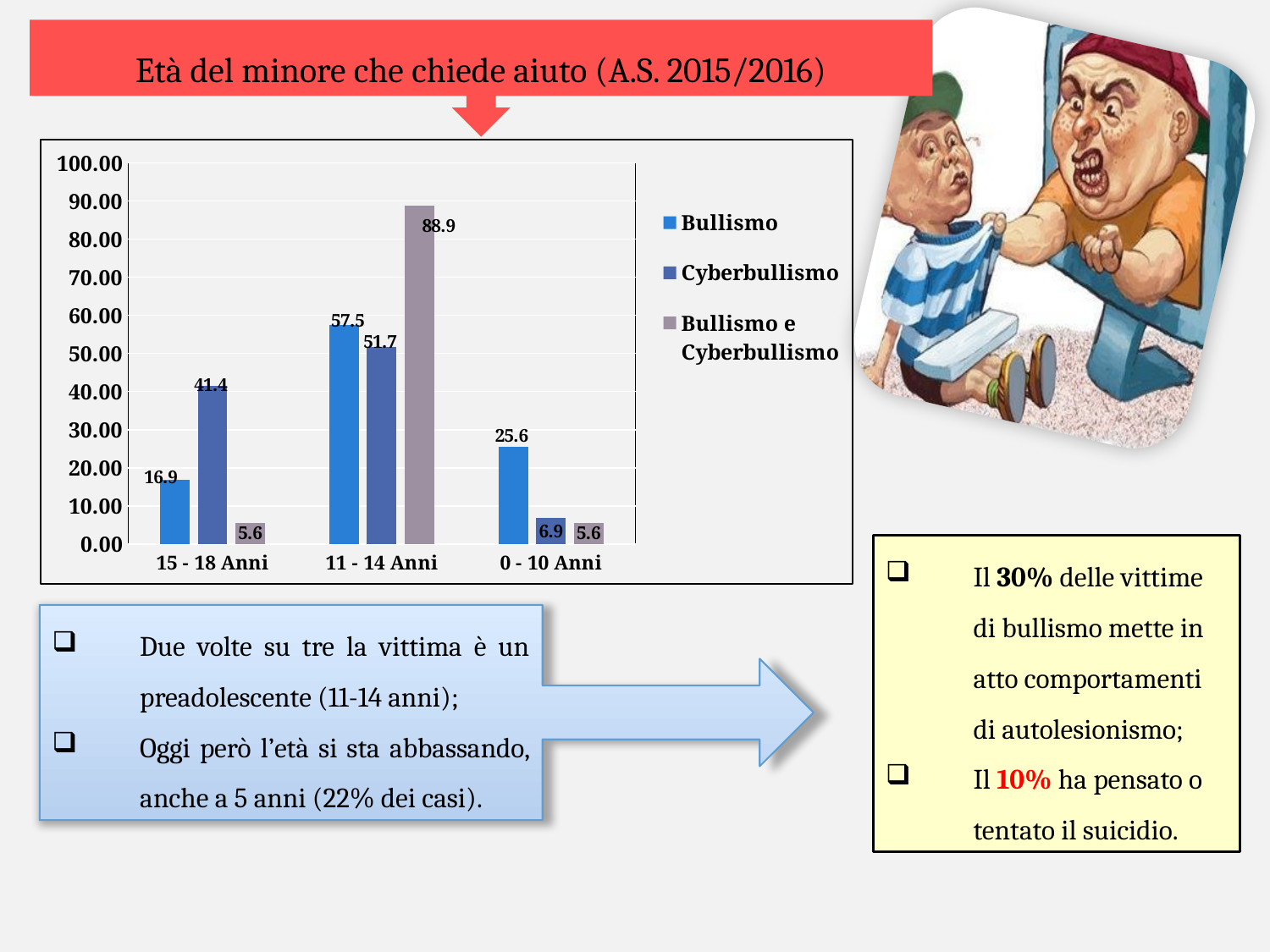
What is the difference between the Bullismo values for 11 - 14 Anni and 15 - 18 Anni? 40.6 Which is larger for the 15 - 18 Anni group: the Bullismo value or the Cyberbullismo value? Cyberbullismo What is the Cyberbullismo value for the 0 - 10 Anni age group? 6.9 What is the Bullismo e Cyberbullismo value for the 11 - 14 Anni age group? 88.9 Which age group has the lowest Cyberbullismo value? 0 - 10 Anni How many age groups are shown on the x axis? 3 What is the title shown above the chart? Età del minore che chiede aiuto (A.S. 2015/2016) What kind of chart is shown on the slide? Bar chart Which age group has the highest Bullismo value? 11 - 14 Anni What is the Cyberbullismo value for the 15 - 18 Anni age group? 41.4 What is the Bullismo value for the 11 - 14 Anni age group? 57.5 How many series does the legend list? 3